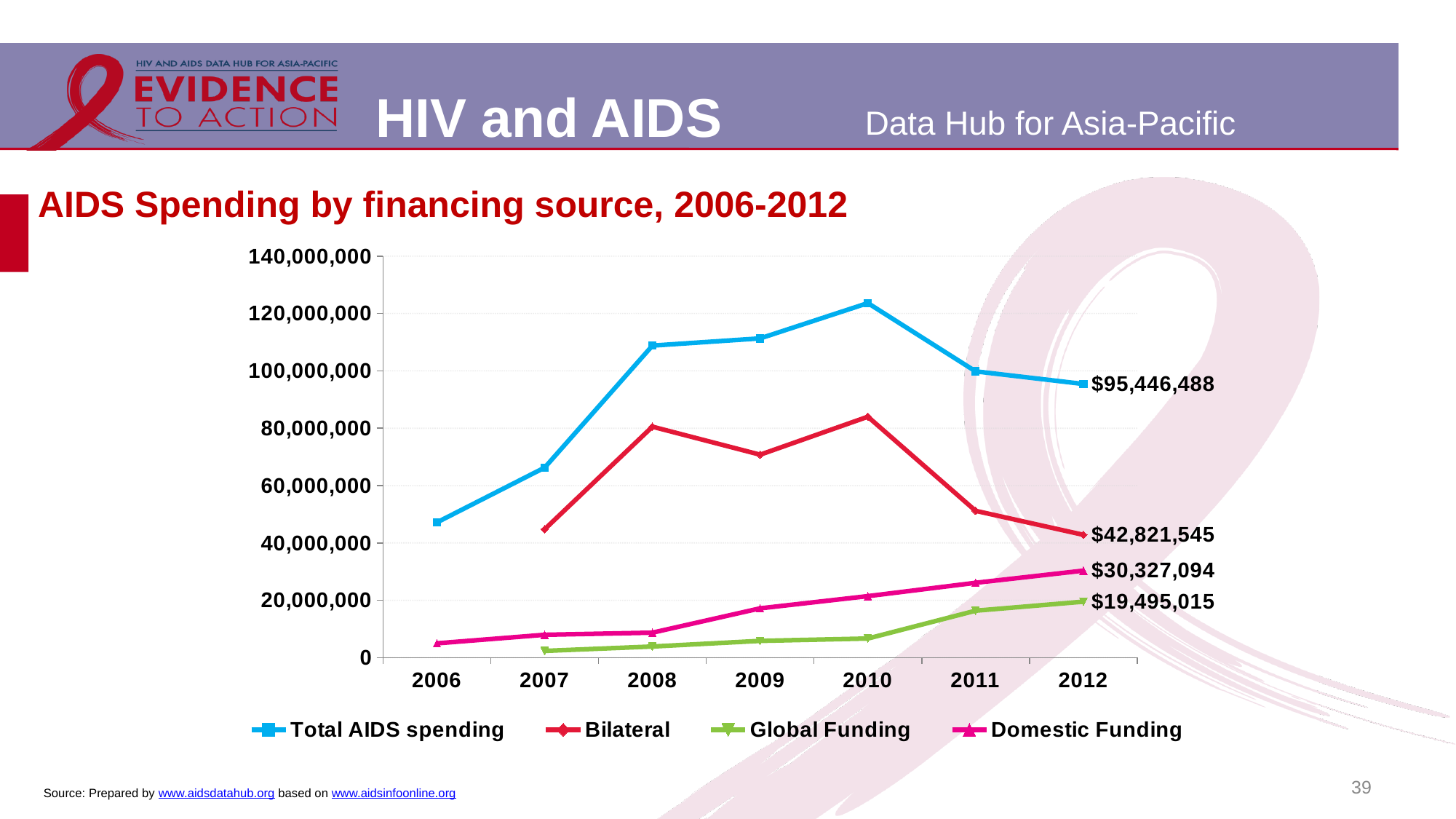
What is the value for Total AIDS spending in 2012? $95,446,488 Is the value for Total AIDS spending in 2010 greater or less than 120,000,000? greater What is the value for Domestic Funding in 2012? $30,327,094 What is the value for Global Funding in 2012? $19,495,015 In which year is Total AIDS spending at its lowest? 2006 How many series does the legend list? 4 Which is larger in 2012, Bilateral or Domestic Funding? Bilateral In which year does Total AIDS spending reach its highest value? 2010 What kind of chart is shown on the slide? Line chart What is the difference between Total AIDS spending and Bilateral in 2012? $52,624,943 How many years are shown on the x axis? 7 What is the value for Bilateral in 2012? $42,821,545